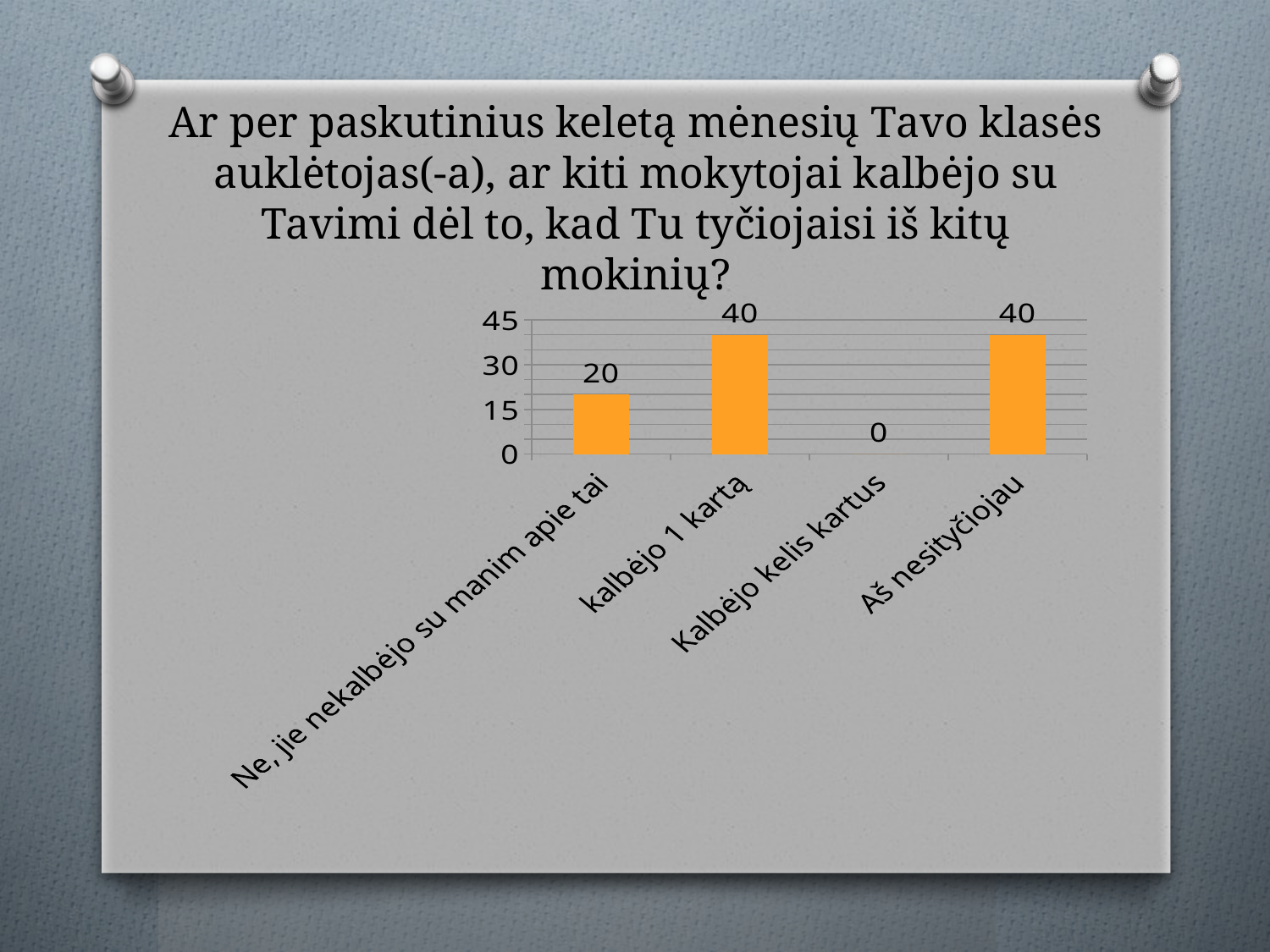
What kind of chart is shown on the slide? bar chart Is the value for "Ne, jie nekalbėjo su manim apie tai" greater or less than 30? less What is the highest tick value shown on the vertical axis? 45 How many categories are shown on the x axis? 4 Which is larger: the value for "Aš nesityčiojau" or the value for "Ne, jie nekalbėjo su manim apie tai"? Aš nesityčiojau Which category has the lowest value? Kalbėjo kelis kartus What is the difference between the values for "kalbėjo 1 kartą" and "Ne, jie nekalbėjo su manim apie tai"? 20 Is the value for "kalbėjo 1 kartą" greater or less than 30? greater What is the value for "kalbėjo 1 kartą"? 40 What is the value for "Kalbėjo kelis kartus"? 0 What is the value for "Ne, jie nekalbėjo su manim apie tai"? 20 What is the value for "Aš nesityčiojau"? 40